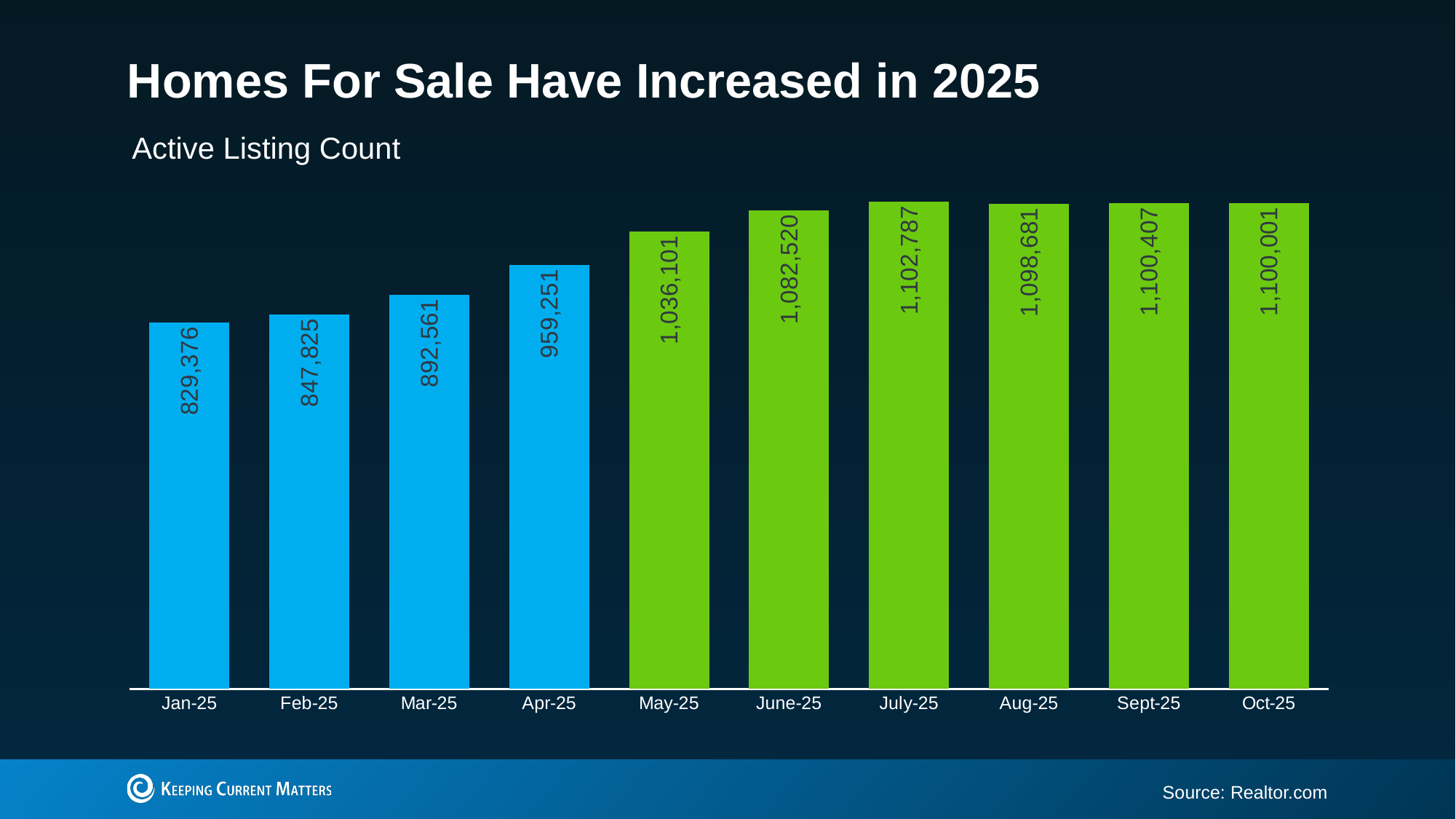
What is the subtitle shown above the chart? Active Listing Count What kind of chart is shown on the slide? Bar chart How many months are shown in the chart? 10 What is the active listing count for Jan-25? 829,376 Which month has the highest active listing count? July-25 What is the difference between the active listing counts for Oct-25 and Jan-25? 270,625 What is the active listing count for July-25? 1,102,787 What is the difference between the active listing counts for Apr-25 and Mar-25? 66,690 Which month has the lowest active listing count? Jan-25 Do the active listing counts rise or fall from Jan-25 to July-25? Rise What is the active listing count for Oct-25? 1,100,001 Which is larger, the active listing count for Mar-25 or Feb-25? Mar-25